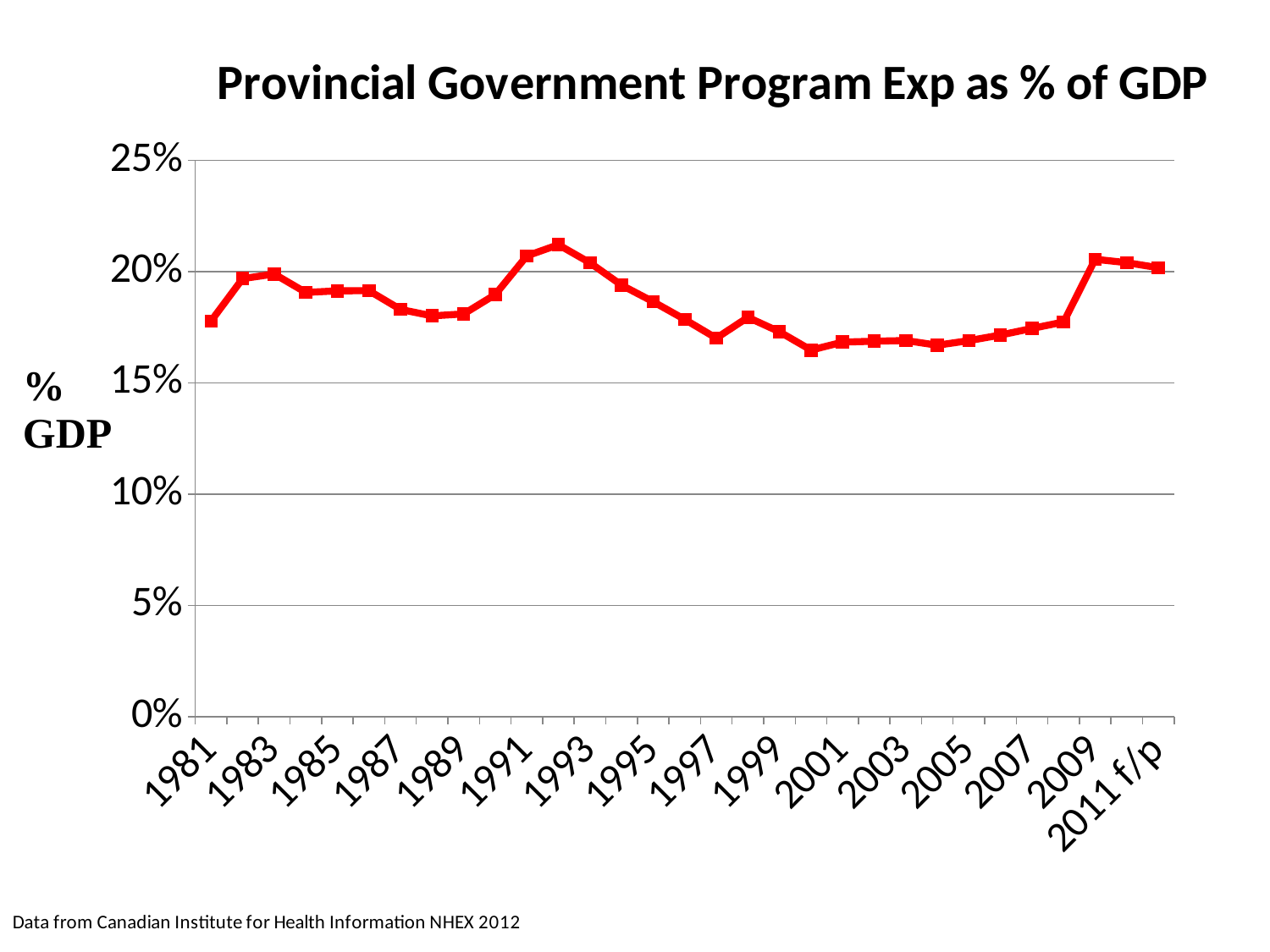
Which year has the larger value, 2009 or 2007? 2009 Is the value for 2005 greater or less than 15%? greater What is the title of the chart? Provincial Government Program Exp as % of GDP Is the value for 2001 greater or less than 20%? less Does the value rise or fall from 2005 to 2009? rise Does the value rise or fall from 1993 to 1997? fall What kind of chart is shown on the slide? line chart Is the value for 1989 greater or less than 20%? less Which year has the larger value, 1983 or 1981? 1983 Which year has the larger value, 1991 or 2001? 1991 What colour is the plotted line? red